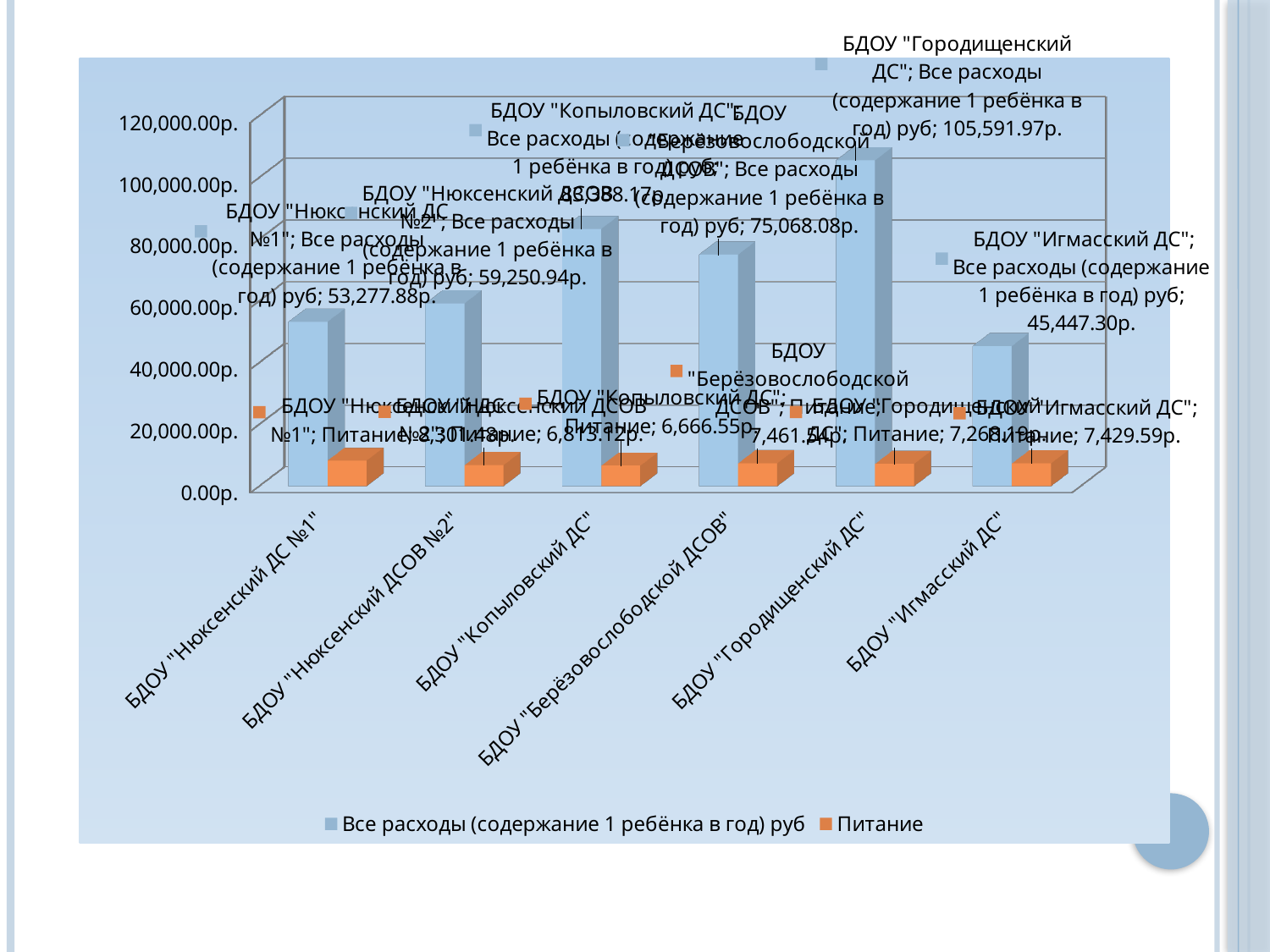
What is the value of "Питание" for БДОУ "Игмасский ДС"? 7,429.59р. Which institution has the highest value for "Все расходы (содержание 1 ребёнка в год) руб"? БДОУ "Городищенский ДС" What is the value of "Все расходы (содержание 1 ребёнка в год) руб" for БДОУ "Городищенский ДС"? 105,591.97р. Is the value of "Все расходы (содержание 1 ребёнка в год) руб" for БДОУ "Городищенский ДС" greater or less than 100,000.00р.? greater Which institution has the lowest value for "Все расходы (содержание 1 ребёнка в год) руб"? БДОУ "Игмасский ДС" How many series does the legend list? 2 What is the value of "Все расходы (содержание 1 ребёнка в год) руб" for БДОУ "Игмасский ДС"? 45,447.30р. Which has the larger value for "Все расходы (содержание 1 ребёнка в год) руб": БДОУ "Берёзовослободской ДСОВ" or БДОУ "Нюксенский ДСОВ №2"? БДОУ "Берёзовослободской ДСОВ" What type of chart is shown on the slide? Bar chart What is the difference in "Все расходы (содержание 1 ребёнка в год) руб" between БДОУ "Городищенский ДС" and БДОУ "Игмасский ДС"? 60,144.67р. How many institutions (categories) are shown on the x axis? 6 What is the value of "Питание" for БДОУ "Копыловский ДС"? 6,666.55р.